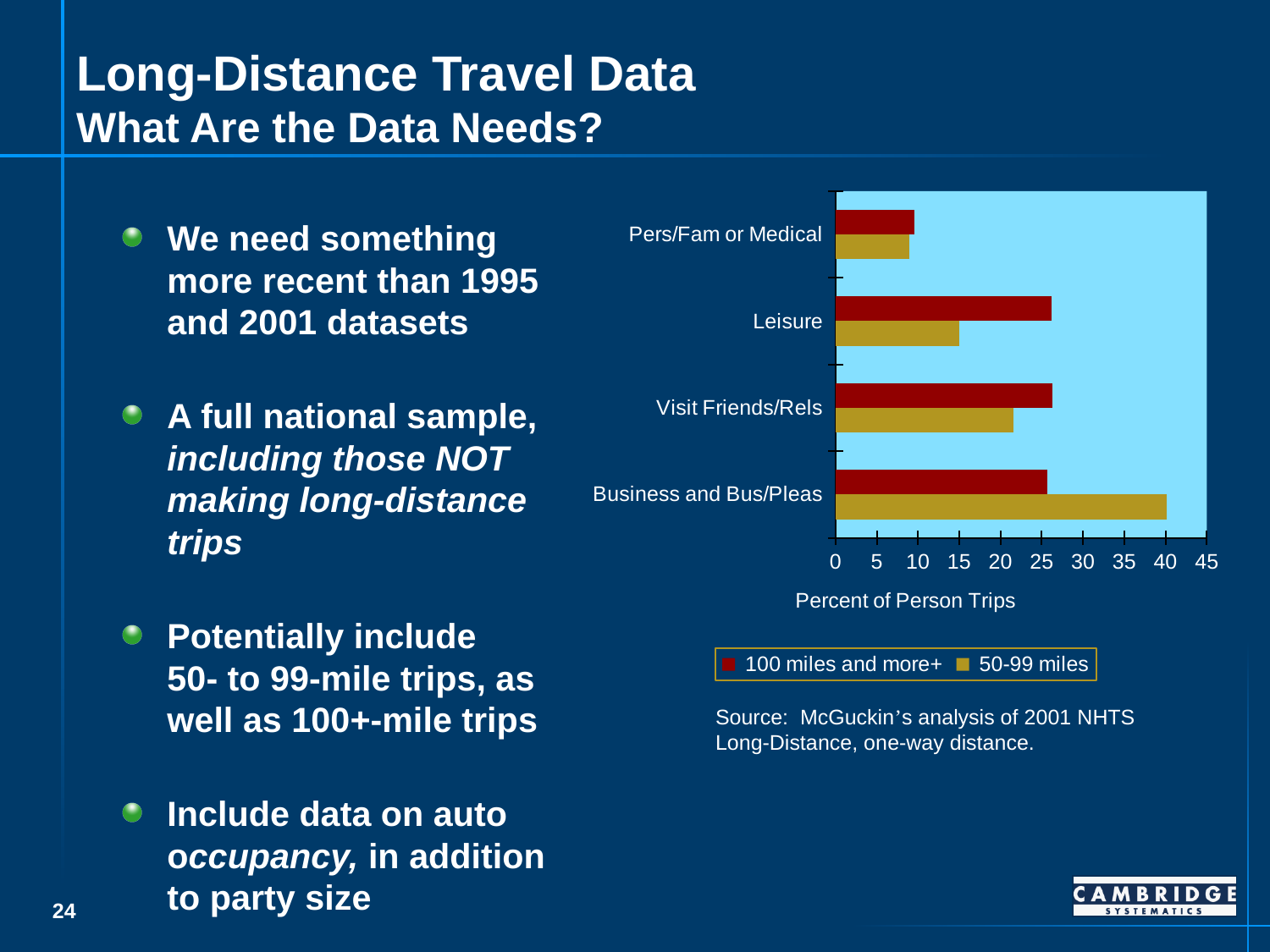
What kind of chart is shown on the slide? bar chart Is the 50-99 miles value for Business and Bus/Pleas greater or less than 35? greater For Business and Bus/Pleas, which series has the larger value: 100 miles and more+ or 50-99 miles? 50-99 miles Is the 50-99 miles value for Leisure greater or less than 20? less How many categories are plotted on the chart? 4 Which series does the gold colour represent in the chart? 50-99 miles What is the label of the horizontal axis of the chart? Percent of Person Trips Which category has the highest value for the 50-99 miles series? Business and Bus/Pleas Which category has the lowest value for the 50-99 miles series? Pers/Fam or Medical Which category has the lowest value for the 100 miles and more+ series? Pers/Fam or Medical How many series does the chart's legend list? 2 Is the 100 miles and more+ value for Pers/Fam or Medical greater or less than 15? less